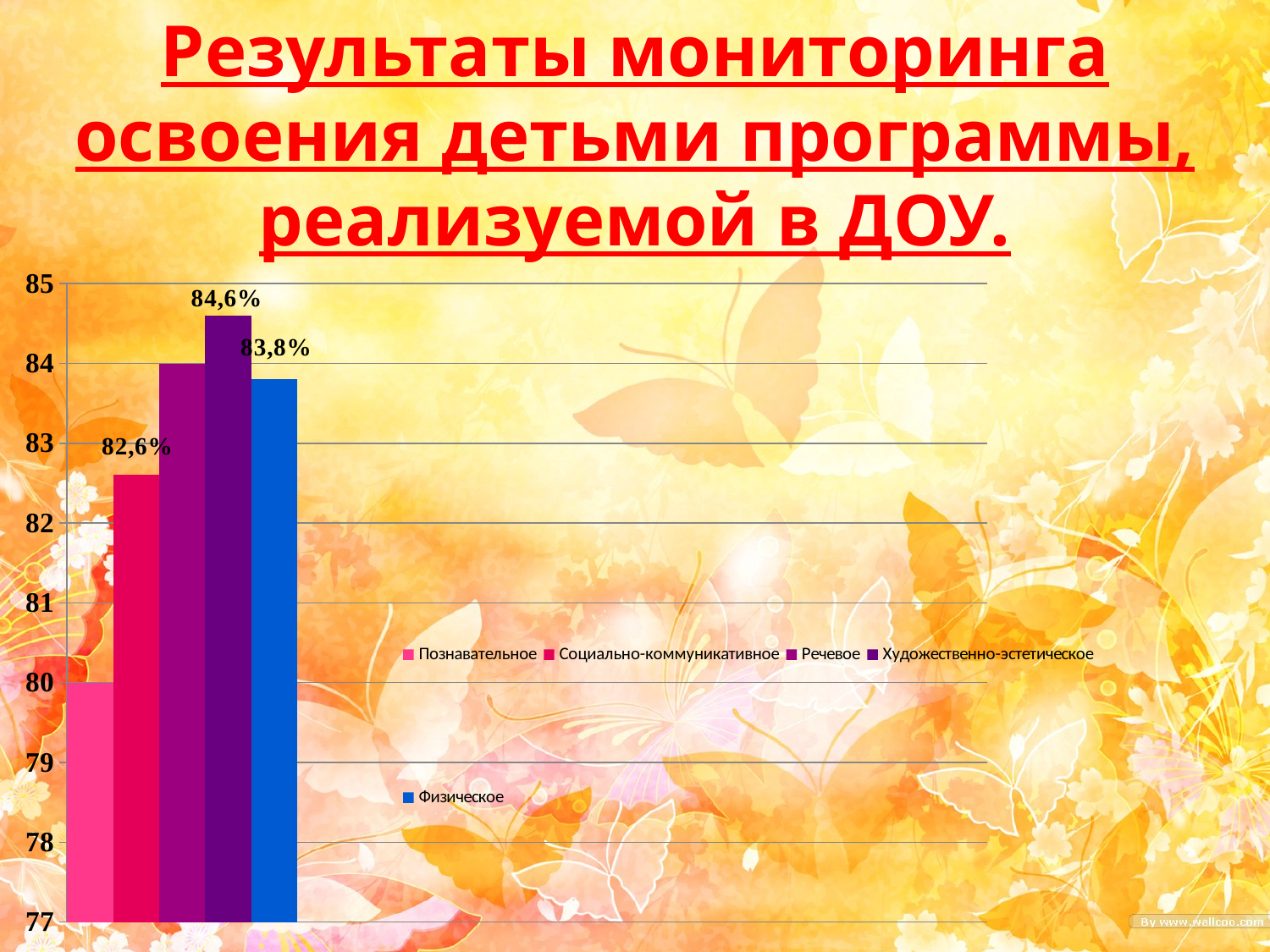
Which series has the highest value? Художественно-эстетическое What is the value for Художественно-эстетическое? 84,6% What kind of chart is shown on the slide? bar chart Is the value for Познавательное greater or less than 81? less What is the value for Физическое? 83,8% What is the difference between the values for Художественно-эстетическое and Физическое? 0,8% Which series has the lowest value? Познавательное What is the difference between the values for Художественно-эстетическое and Социально-коммуникативное? 2% Which is larger, the value for Физическое or the value for Социально-коммуникативное? Физическое Is the value for Речевое greater or less than 83? greater What is the value for Социально-коммуникативное? 82,6% How many series does the legend list? 5